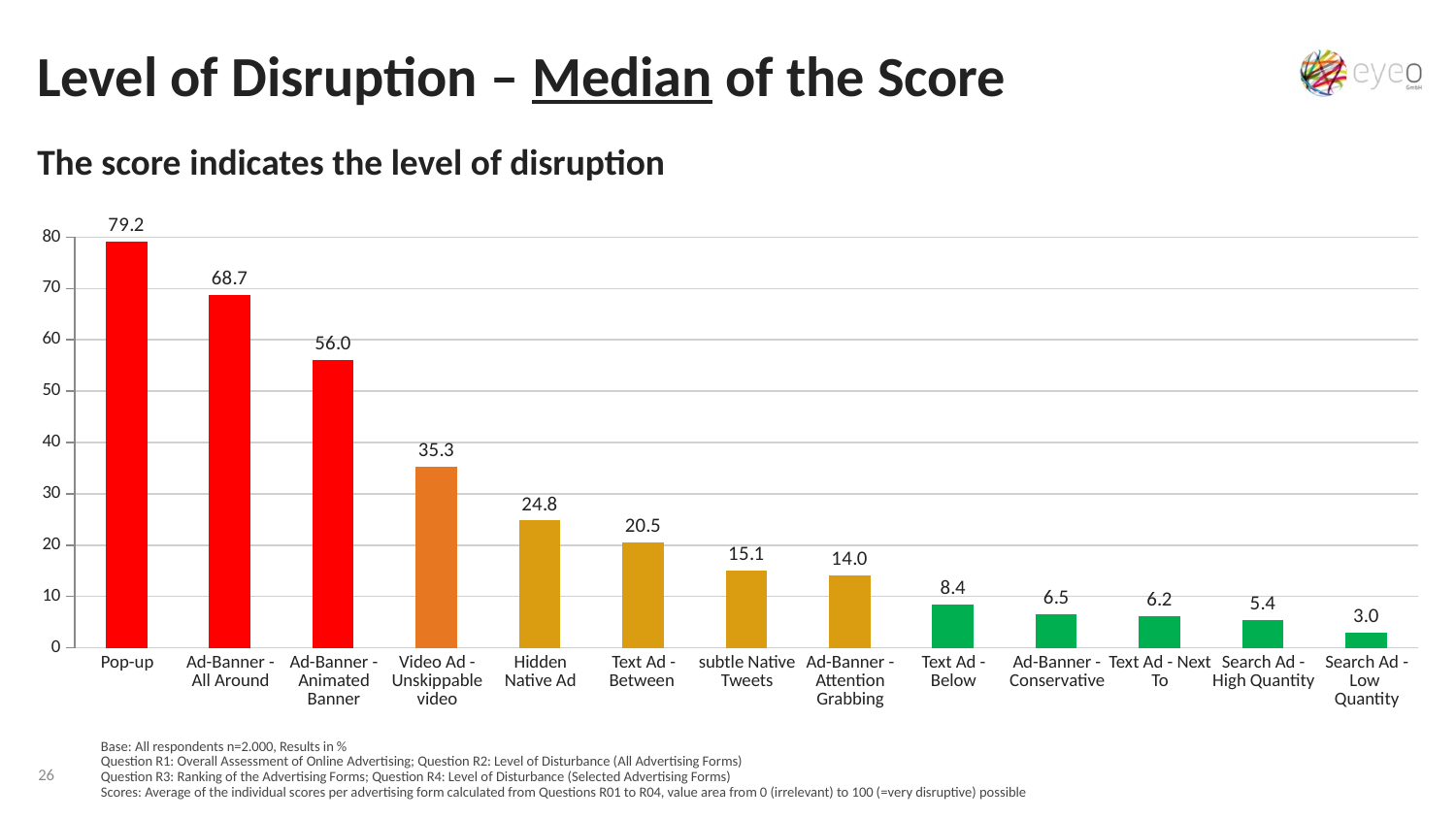
What is the difference between the scores for Ad-Banner - All Around and Ad-Banner - Animated Banner? 12.7 Which advertising form has the lowest median disruption score? Search Ad - Low Quantity What is the median disruption score for Hidden Native Ad? 24.8 What is the median disruption score for Video Ad - Unskippable video? 35.3 Do the scores rise or fall from left to right across the chart? Fall How many advertising forms are shown in the chart? 13 Which advertising form has the highest median disruption score? Pop-up Which has a higher score, Text Ad - Between or subtle Native Tweets? Text Ad - Between What is the median disruption score for Pop-up? 79.2 What is the median disruption score for Text Ad - Below? 8.4 What colour is the bar for Video Ad - Unskippable video? Orange What type of chart is shown on the slide? Bar chart